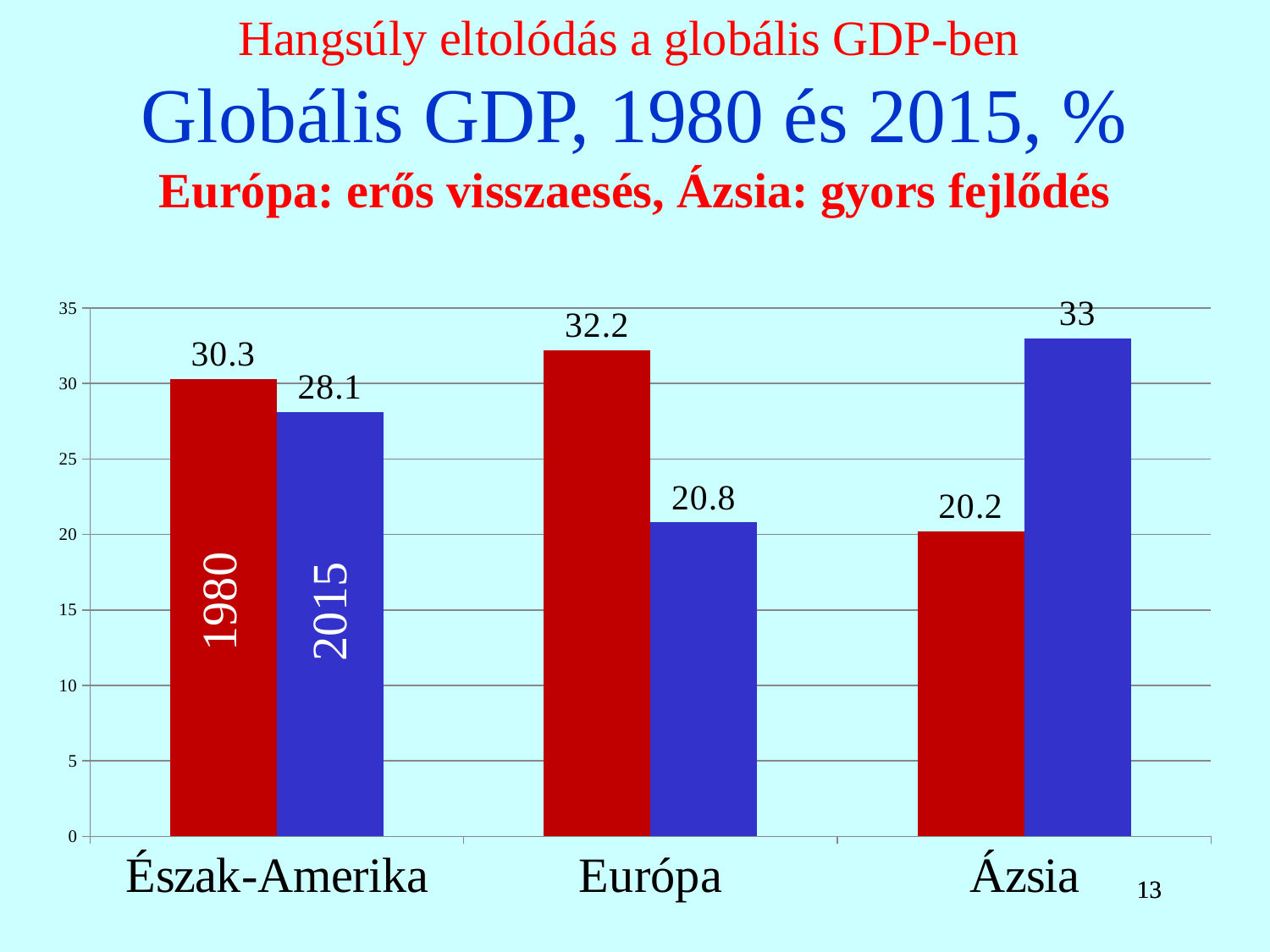
Is the value for Ázsia in 1980 greater or less than 25? less Which is larger for Észak-Amerika: the 1980 value or the 2015 value? 1980 Which region has the lowest value in 1980? Ázsia What kind of chart is shown on the slide? bar chart What is the value for Európa in 1980? 32.2 How many regions are shown on the x axis? 3 How many series (years) does the chart show? 2 What colour are the bars for 1980? red Which region has the highest value in 2015? Ázsia What is the difference between the 1980 and 2015 values for Európa? 11.4 What is the value for Észak-Amerika in 2015? 28.1 What is the value for Ázsia in 2015? 33